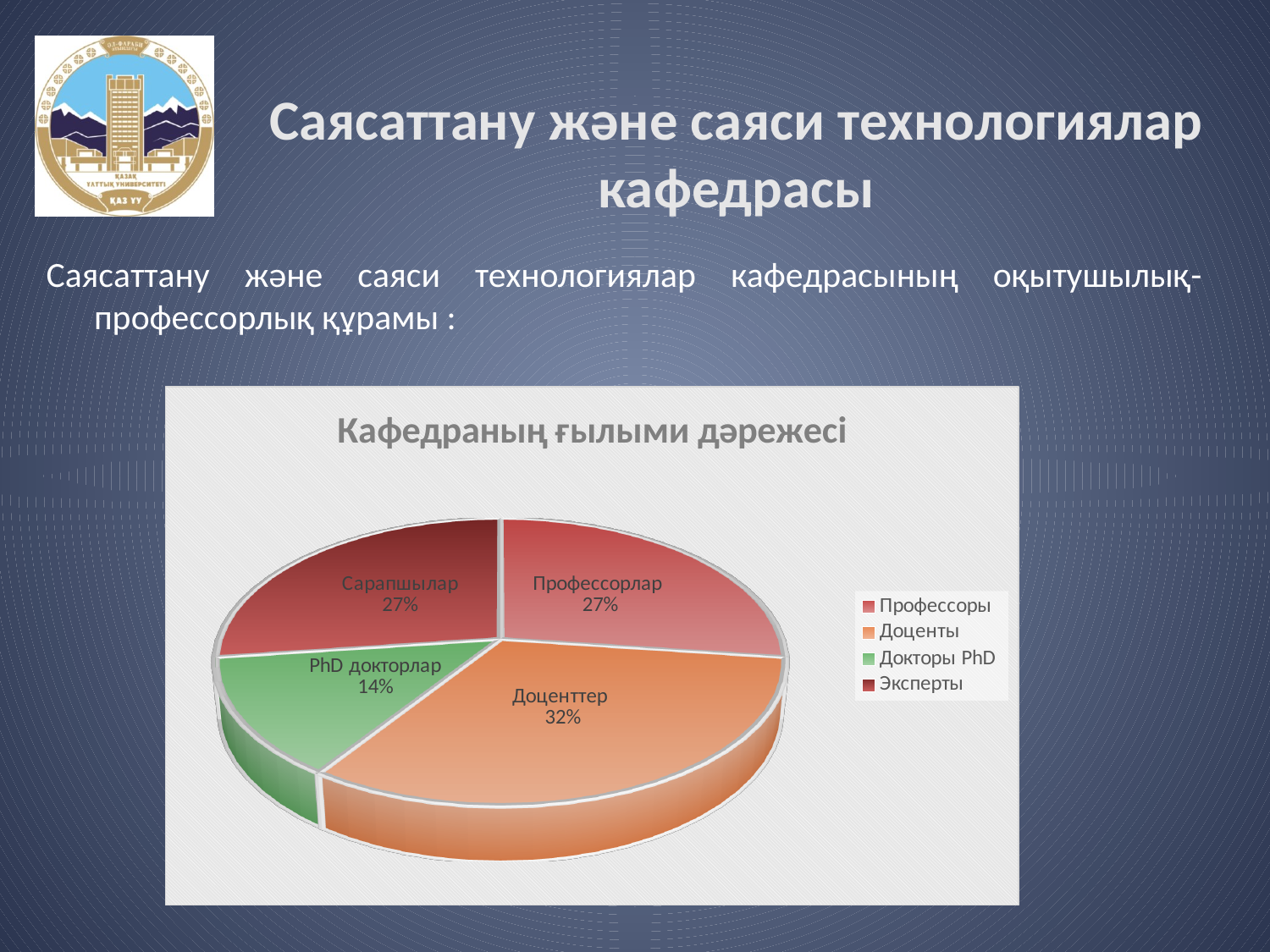
How many slices does the pie chart have? 4 What is the title of the chart? Кафедраның ғылыми дәрежесі What is the difference in percentage points between the Доценттер slice and the PhD докторлар slice? 18 How many entries does the legend list? 4 Which is larger, the Доценттер slice or the Профессорлар slice? Доценттер What share of the pie is labelled PhD докторлар? 14% What kind of chart is shown on the slide? pie chart Which slice of the pie is the smallest? PhD докторлар What share of the pie is labelled Сарапшылар? 27% What share of the pie is labelled Профессорлар? 27% Which slice of the pie is the largest? Доценттер